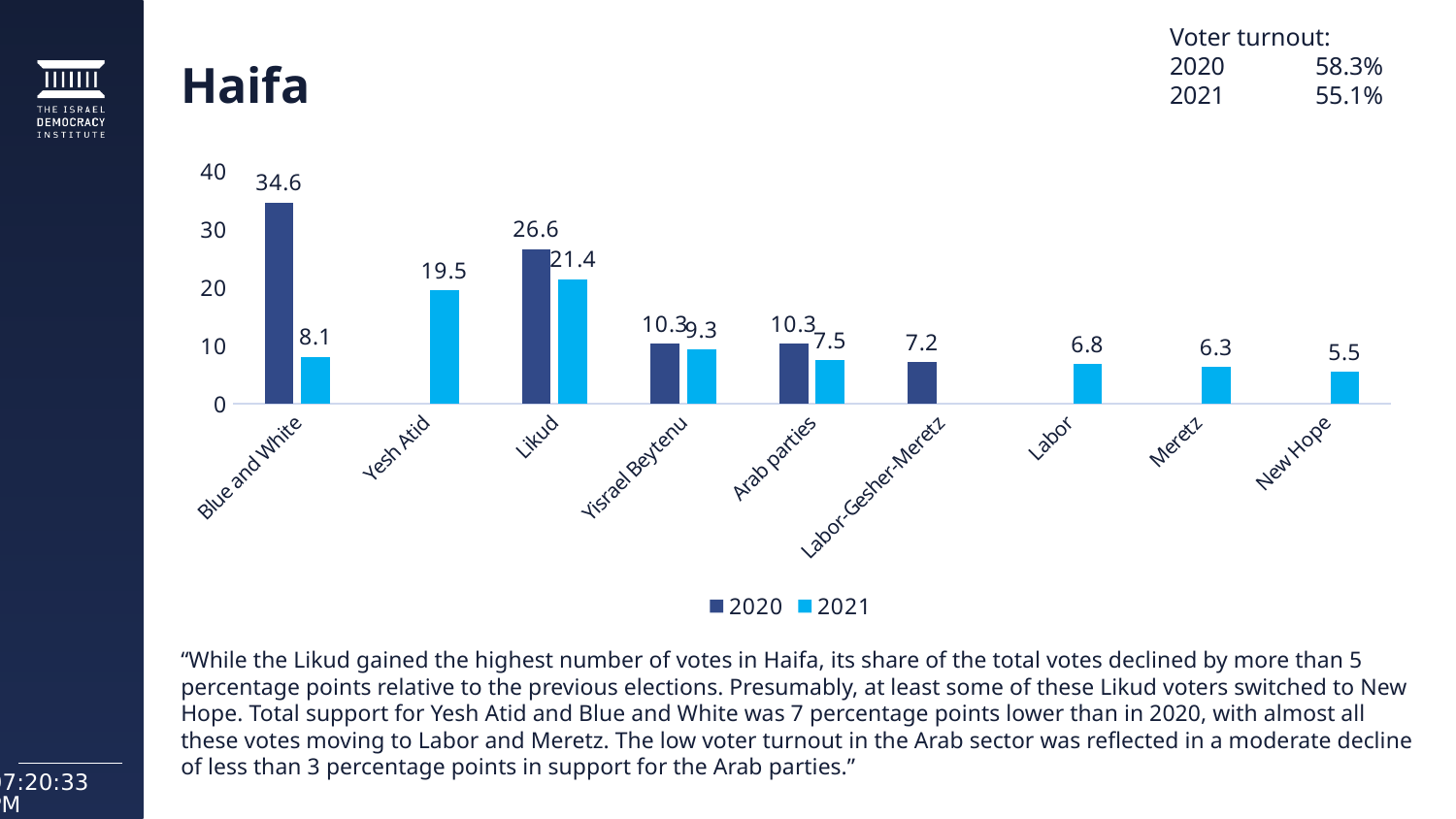
How many party categories are shown on the x axis? 9 Which party had the highest value in 2021? Likud Which was larger in 2021: Labor or Meretz? Labor How many series does the legend list? 2 What was Yesh Atid's value in 2021? 19.5 Which party had the lowest value in 2021? New Hope What is the difference between Blue and White's 2020 and 2021 values? 26.5 What kind of chart is shown on the slide? Bar chart What was the value for New Hope in 2021? 5.5 By how much did Likud's value fall from 2020 to 2021? 5.2 What was Blue and White's value in 2020? 34.6 What was Likud's value in 2021? 21.4